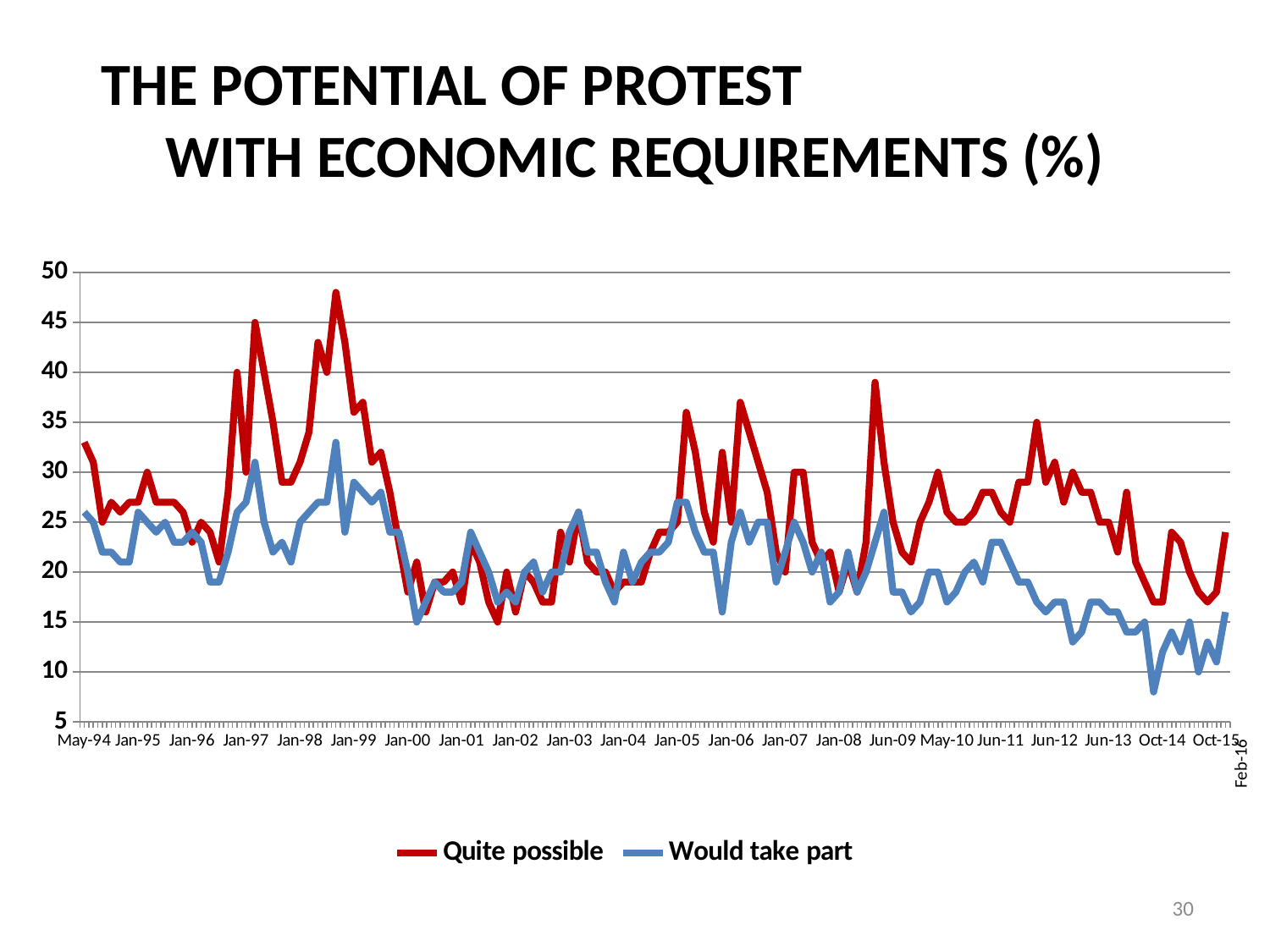
Does the 'Would take part' series generally rise or fall between Jun-11 and Oct-14? fall Is the lowest value of the 'Would take part' series, near Oct-14, greater or less than 10? less What kind of chart is shown on the slide? line chart Which colour is used for the 'Would take part' series? blue How many series does the legend list? 2 Is the peak value of the 'Would take part' series around Jan-99 greater or less than 30? greater Is the peak value of the 'Quite possible' series around Jan-99 greater or less than 45? greater What are the two series named in the legend? Quite possible; Would take part Around Jan-97, which series has the higher value, 'Quite possible' or 'Would take part'? Quite possible Which series reaches the highest value anywhere on the chart? Quite possible Does the 'Quite possible' series rise or fall between Jan-99 and Jan-00? fall